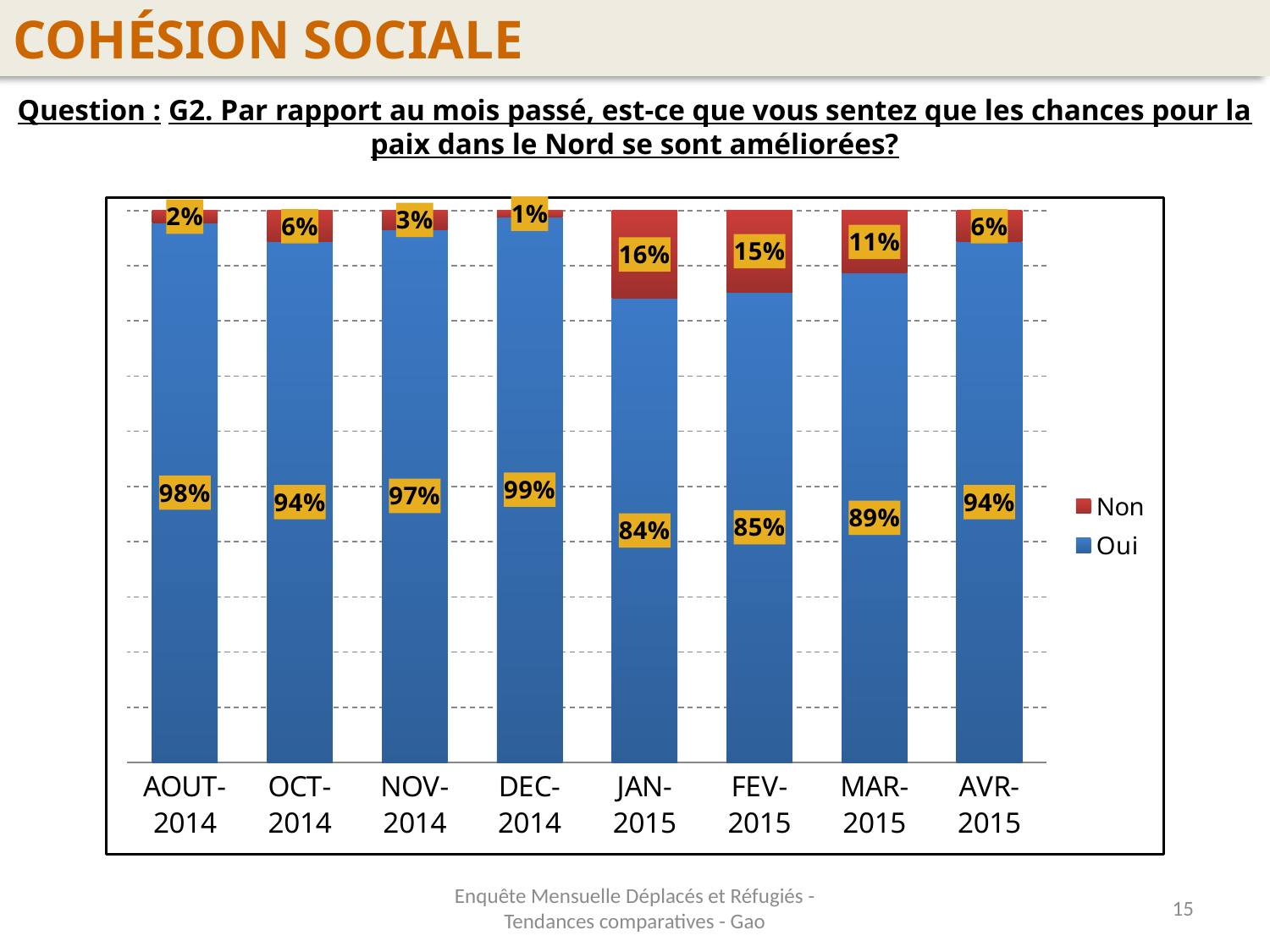
What kind of chart is shown on the slide? Stacked bar chart What is the difference between the Oui values for DEC-2014 and JAN-2015? 15% What is the value for Oui in DEC-2014? 99% How many series does the legend list? 2 What is the value for Non in MAR-2015? 11% Which month has the lowest value for Oui? JAN-2015 Which month has the highest value for Non? JAN-2015 How many months are shown on the x axis? 8 What is the total of the stacked bar for OCT-2014? 100% What is the value for Oui in JAN-2015? 84% Which month has the lowest value for Non? DEC-2014 Which is larger, the Non value for FEV-2015 or the Non value for AVR-2015? FEV-2015